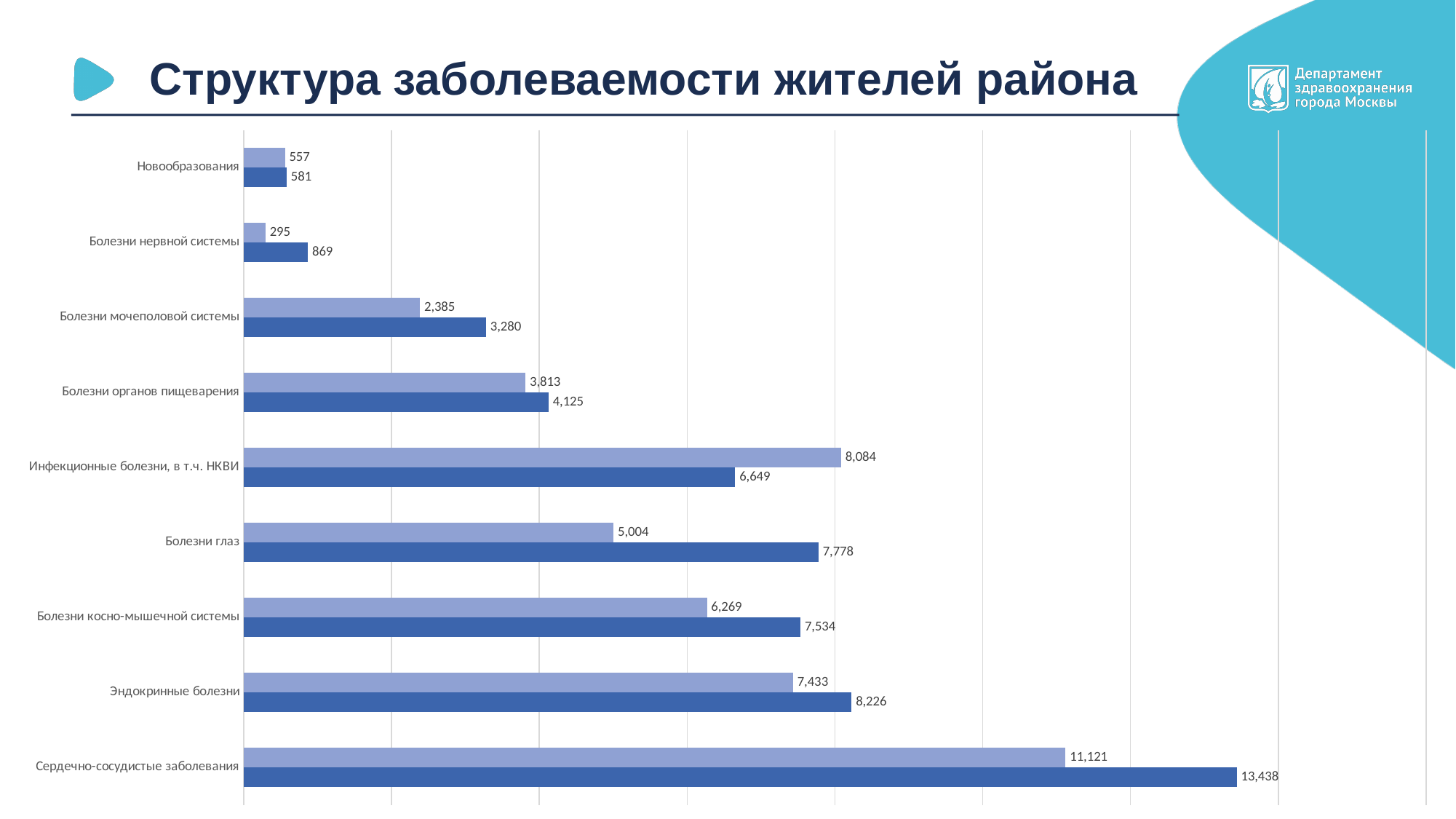
What is the light blue bar value for Эндокринные болезни? 7,433 What is the difference between the dark blue and light blue values for Болезни глаз? 2,774 What is the dark blue bar value for Сердечно-сосудистые заболевания? 13,438 For Инфекционные болезни, в т.ч. НКВИ, which bar is larger, the light blue or the dark blue? Light blue What is the difference between the two bars for Новообразования? 24 Which category has the highest dark blue bar value? Сердечно-сосудистые заболевания What is the title of the slide? Структура заболеваемости жителей района What is the dark blue bar value for Болезни нервной системы? 869 Which category has the lowest light blue bar value? Болезни нервной системы What type of chart is shown on the slide? Bar chart What is the light blue bar value for Инфекционные болезни, в т.ч. НКВИ? 8,084 How many disease categories are shown on the chart? 9